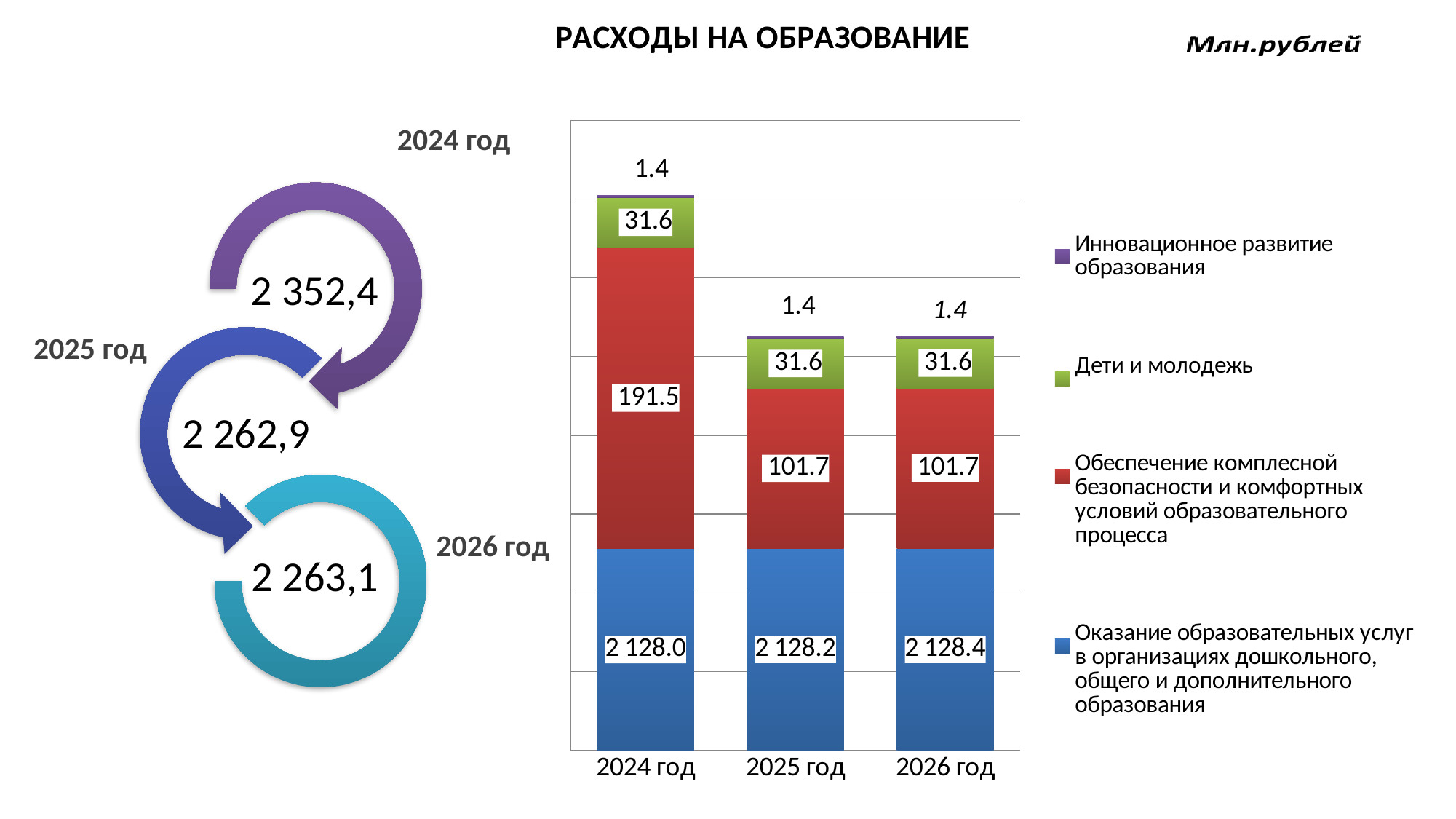
What is the value for «Оказание образовательных услуг в организациях дошкольного, общего и дополнительного образования» in 2024 год? 2 128.0 In which year is the value for «Обеспечение комплесной безопасности и комфортных условий образовательного процесса» the highest? 2024 год How many years are shown on the x axis of the chart? 3 Which year has the larger value for «Оказание образовательных услуг в организациях дошкольного, общего и дополнительного образования»: 2024 год or 2026 год? 2026 год What is the value for «Обеспечение комплесной безопасности и комфортных условий образовательного процесса» in 2024 год? 191.5 What is the value for «Инновационное развитие образования» in 2026 год? 1.4 What kind of chart is shown on the slide? Stacked bar chart What is the value for «Обеспечение комплесной безопасности и комфортных условий образовательного процесса» in 2025 год? 101.7 What is the difference between the «Оказание образовательных услуг...» values for 2026 год and 2024 год? 0.4 What is the value for «Дети и молодежь» in 2026 год? 31.6 By how much does the value for «Обеспечение комплесной безопасности и комфортных условий образовательного процесса» in 2024 год exceed the value in 2025 год? 89.8 How many series does the chart legend list? 4